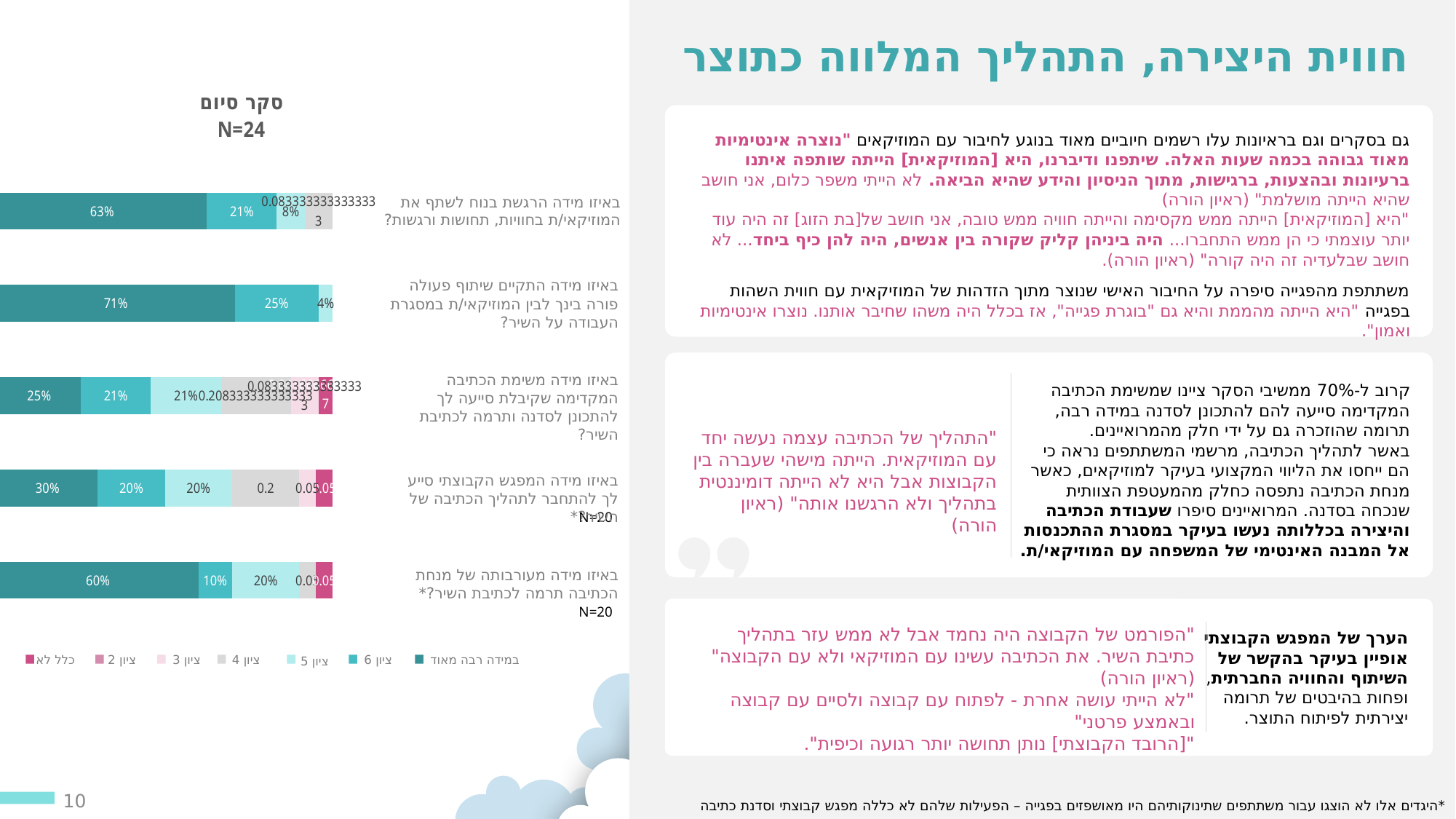
What is the difference in the 'במידה רבה מאוד' share between the cooperation question (71%) and the comfortable-sharing question (63%)? 8 percentage points What share answered 'במידה רבה מאוד' to the question about fruitful cooperation with the musician (שיתוף פעולה פורה)? 71% What share answered 'במידה רבה מאוד' to the question about feeling comfortable sharing experiences and feelings with the musician? 63% How many series does the chart legend list? 7 Which has a larger 'במידה רבה מאוד' share: the question about the writing facilitator's involvement or the question about the group meeting? The writing facilitator's involvement question (60%) What share answered 'ציון 6' to the question about fruitful cooperation with the musician? 25% What kind of chart is shown on the slide? Stacked bar chart What share answered 'במידה רבה מאוד' to the question about the group meeting helping connect to the writing process? 30% How many survey questions (categories) are plotted in the chart? 5 What is the title of the chart? סקר סיום N=24 What share answered 'במידה רבה מאוד' to the question about the writing facilitator's involvement contributing to writing the song? 60% Which survey question has the highest share of 'במידה רבה מאוד' answers? באיזו מידה התקיים שיתוף פעולה פורה בינך לבין המוזיקאי/ת במסגרת העבודה על השיר?